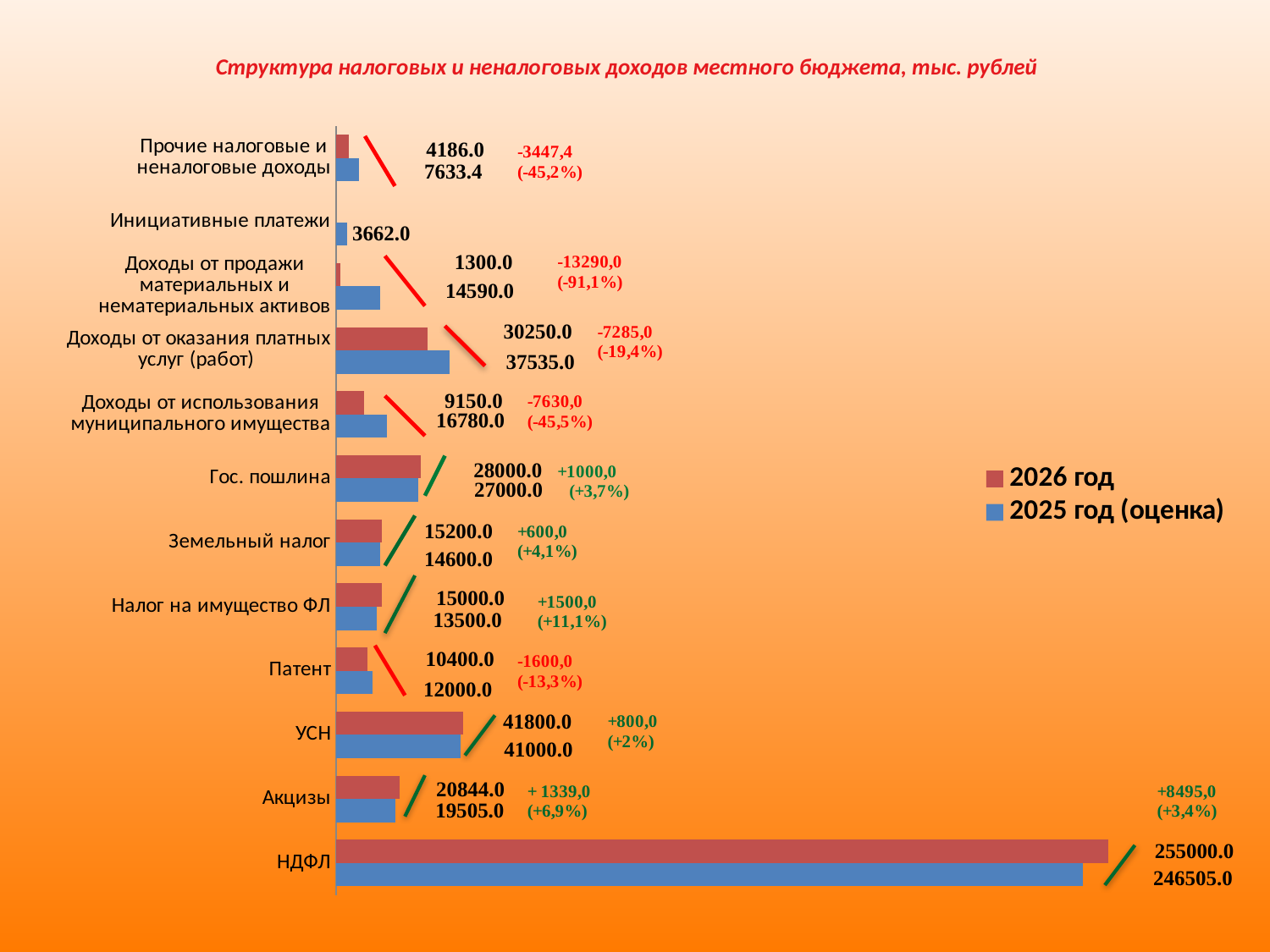
What is the difference between the 2026 год and 2025 год (оценка) values for Гос. пошлина? 1000.0 How many categories are shown on the chart? 12 Which category has the highest value in the 2026 год series? НДФЛ Which category has the lowest value in the 2026 год series? Доходы от продажи материальных и нематериальных активов What kind of chart is shown on the slide? Bar chart What is the value for Инициативные платежи in the 2025 год (оценка) series? 3662.0 What is the title of the chart? Структура налоговых и неналоговых доходов местного бюджета, тыс. рублей What is the value for УСН in the 2025 год (оценка) series? 41000.0 Which is larger for Патент: the 2026 год value or the 2025 год (оценка) value? 2025 год (оценка) How many series does the legend list? 2 What is the value for НДФЛ in the 2026 год series? 255000.0 Which is larger for Акцизы: the 2026 год value or the 2025 год (оценка) value? 2026 год